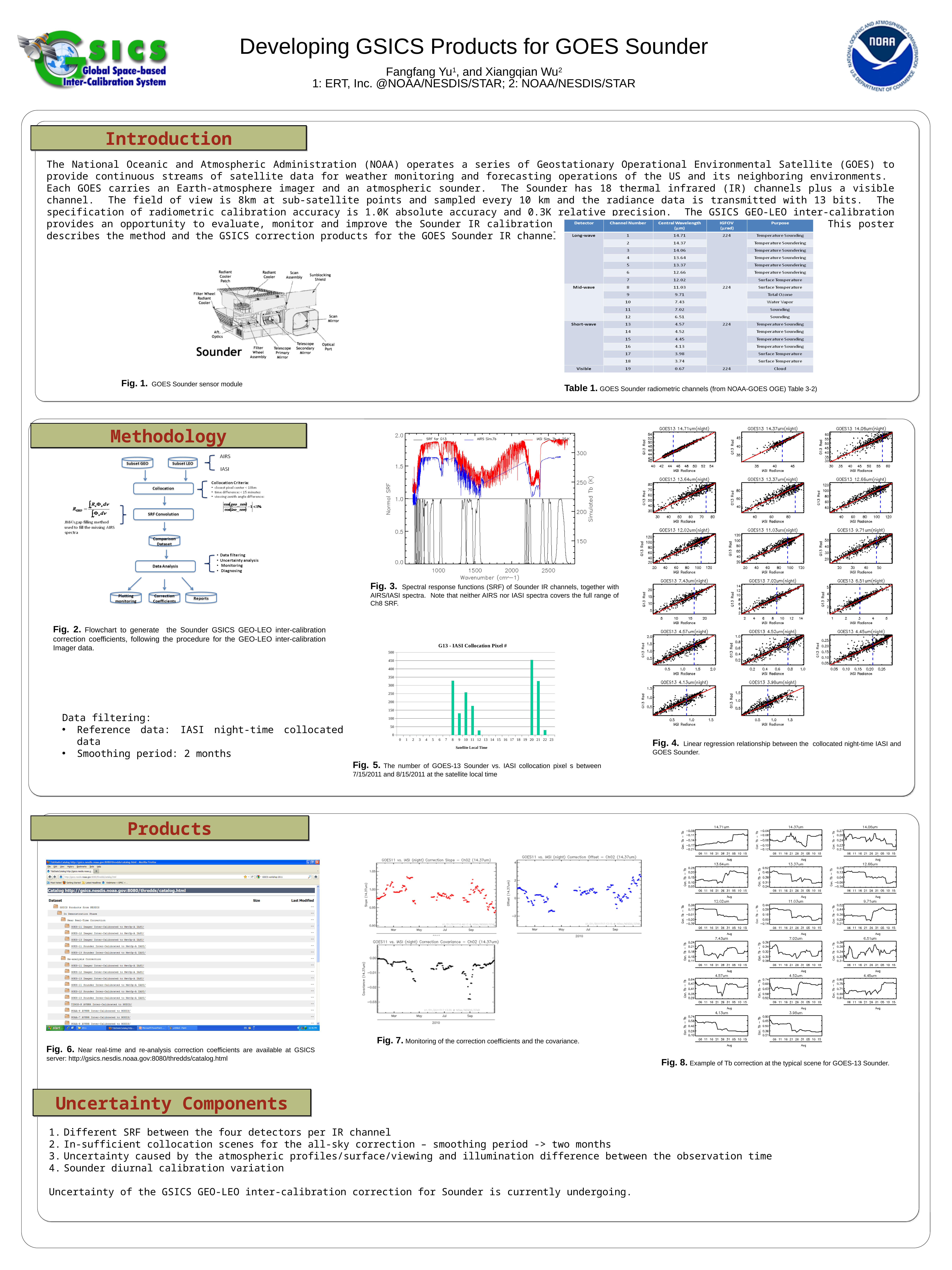
In the chart titled 'G13 - IASI Collocation Pixel #' (Fig. 5), what kind of chart is it? bar chart In the 'G13 - IASI Collocation Pixel #' chart, is the value at satellite local time 12 greater or less than 50? less In the 'G13 - IASI Collocation Pixel #' chart, how many satellite local time hours have a visible (nonzero) bar? 8 In the 'G13 - IASI Collocation Pixel #' chart, is the value at satellite local time 10 greater or less than 200? greater In the 'G13 - IASI Collocation Pixel #' chart, which is larger, the value at satellite local time 20 or at 21? 20 In the 'G13 - IASI Collocation Pixel #' chart, which satellite local time has the highest number of collocation pixels? 20 In the 'G13 - IASI Collocation Pixel #' chart, is the value at satellite local time 20 greater or less than 400? greater What is the x-axis label of the 'G13 - IASI Collocation Pixel #' chart? Satellite Local Time What kind of charts are shown in Fig. 4 (GOES13 vs IASI Radiance panels)? scatter plots In the 'G13 - IASI Collocation Pixel #' chart, which is larger, the value at satellite local time 8 or at 9? 8